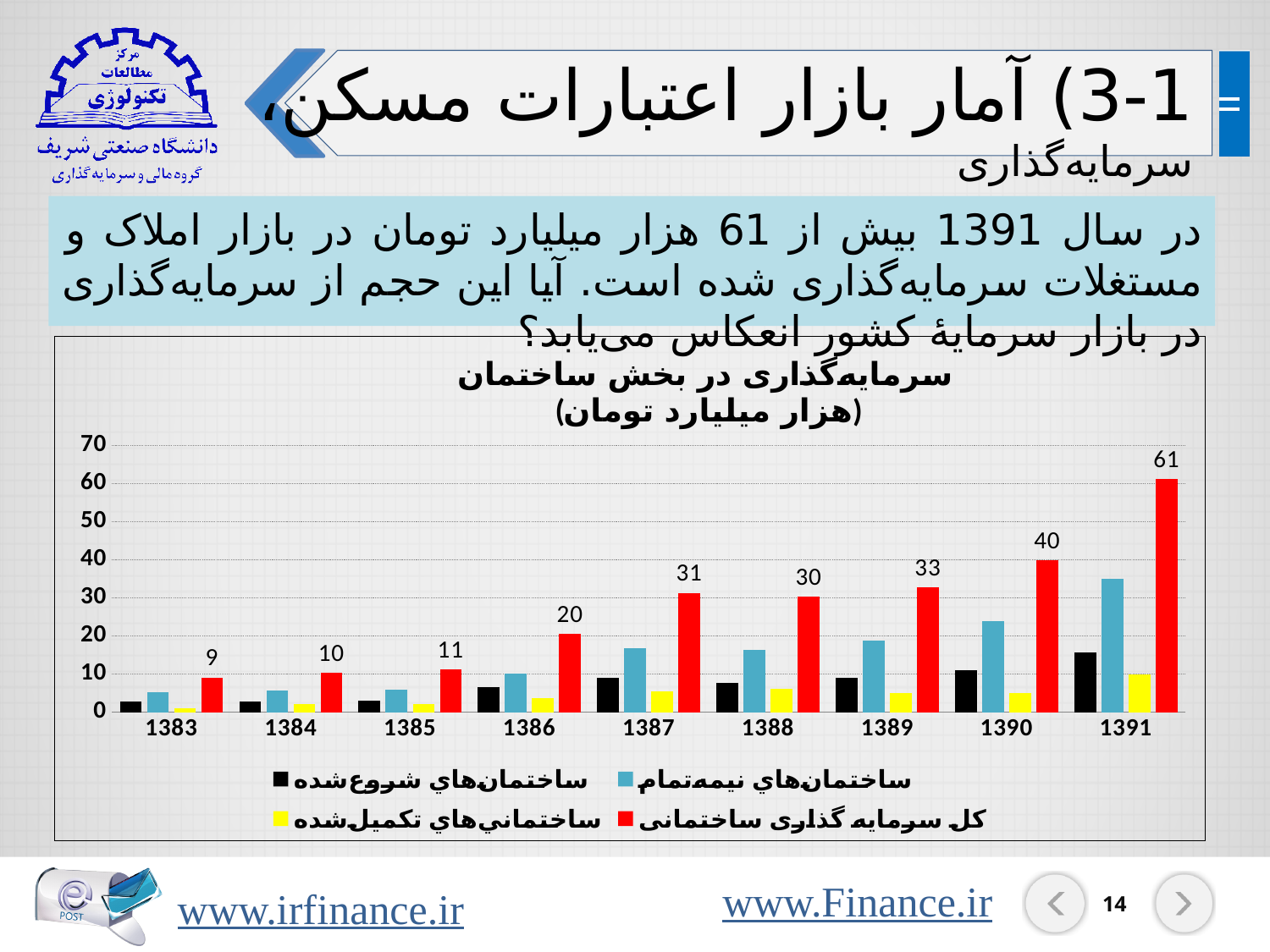
What is the value of the total construction investment (کل سرمایه گذاری ساختمانی) series for 1387? 31 What is the value of the total construction investment (کل سرمایه گذاری ساختمانی) series for 1391? 61 What type of chart is shown on the slide? bar chart How many series does the chart legend list? 4 In which year is the total construction investment (red series) highest? 1391 Is the value of the half-finished buildings (ساختمان‌هاي نيمه‌تمام) series for 1391 greater or less than 30? greater How many years are shown on the x axis of the chart? 9 In which year is the total construction investment (red series) lowest? 1383 What unit is given in the chart title for the values? هزار میلیارد تومان What is the value of the total construction investment (کل سرمایه گذاری ساختمانی) series for 1383? 9 Which year has a larger total construction investment, 1387 or 1388? 1387 What is the difference between the total construction investment in 1391 and in 1390? 21